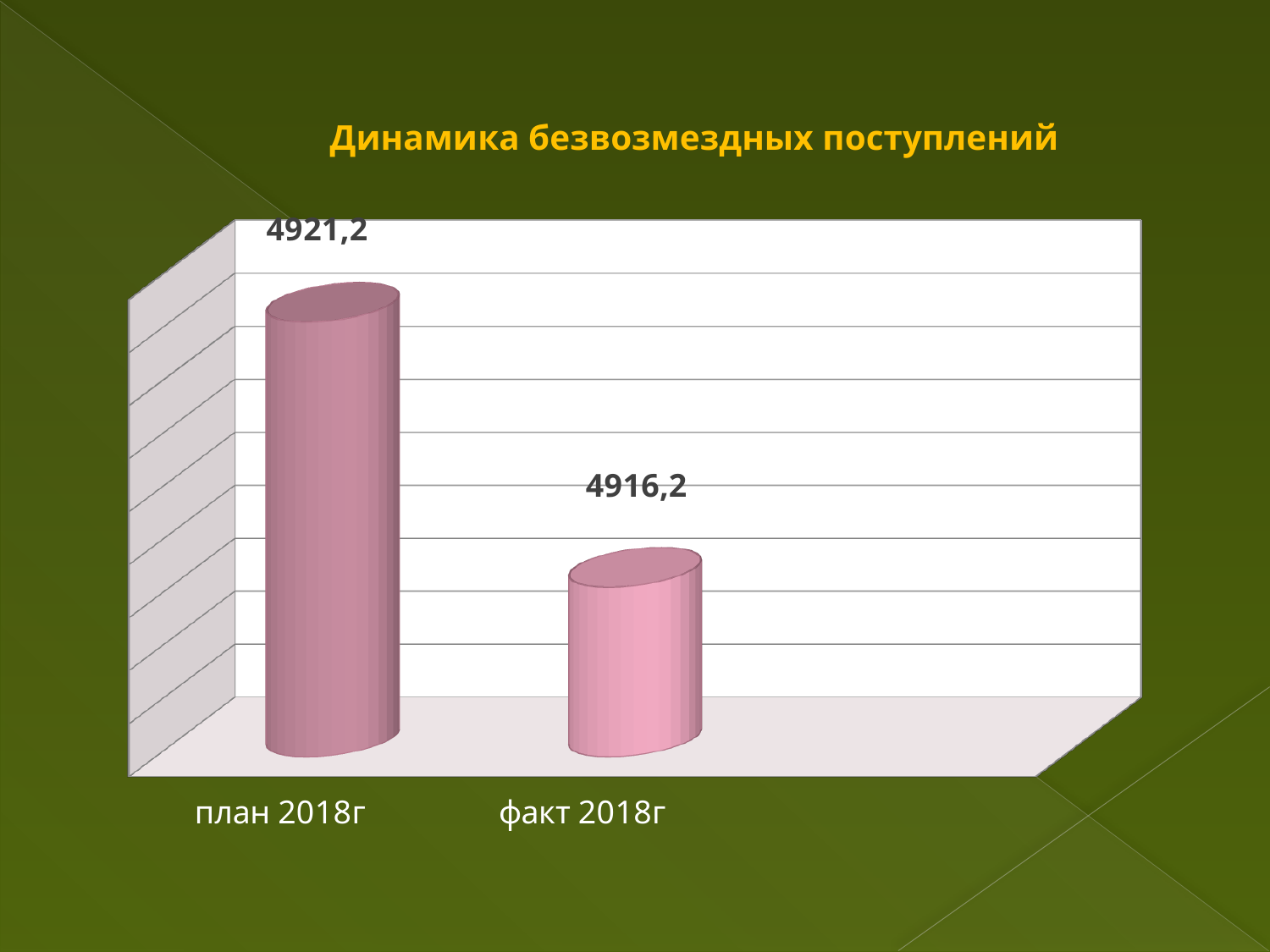
What kind of chart is shown on the slide? bar chart Which category has the highest value? план 2018г What is the value for факт 2018г? 4916,2 Do the values rise or fall from план 2018г to факт 2018г? fall What is the value for план 2018г? 4921,2 What is the title of the chart? Динамика безвозмездных поступлений What is the difference between the values for план 2018г and факт 2018г? 5 Which category has the lowest value? факт 2018г Which is larger, the value for план 2018г or the value for факт 2018г? план 2018г How many categories are shown in the chart? 2 What colour are the bars in the chart? pink